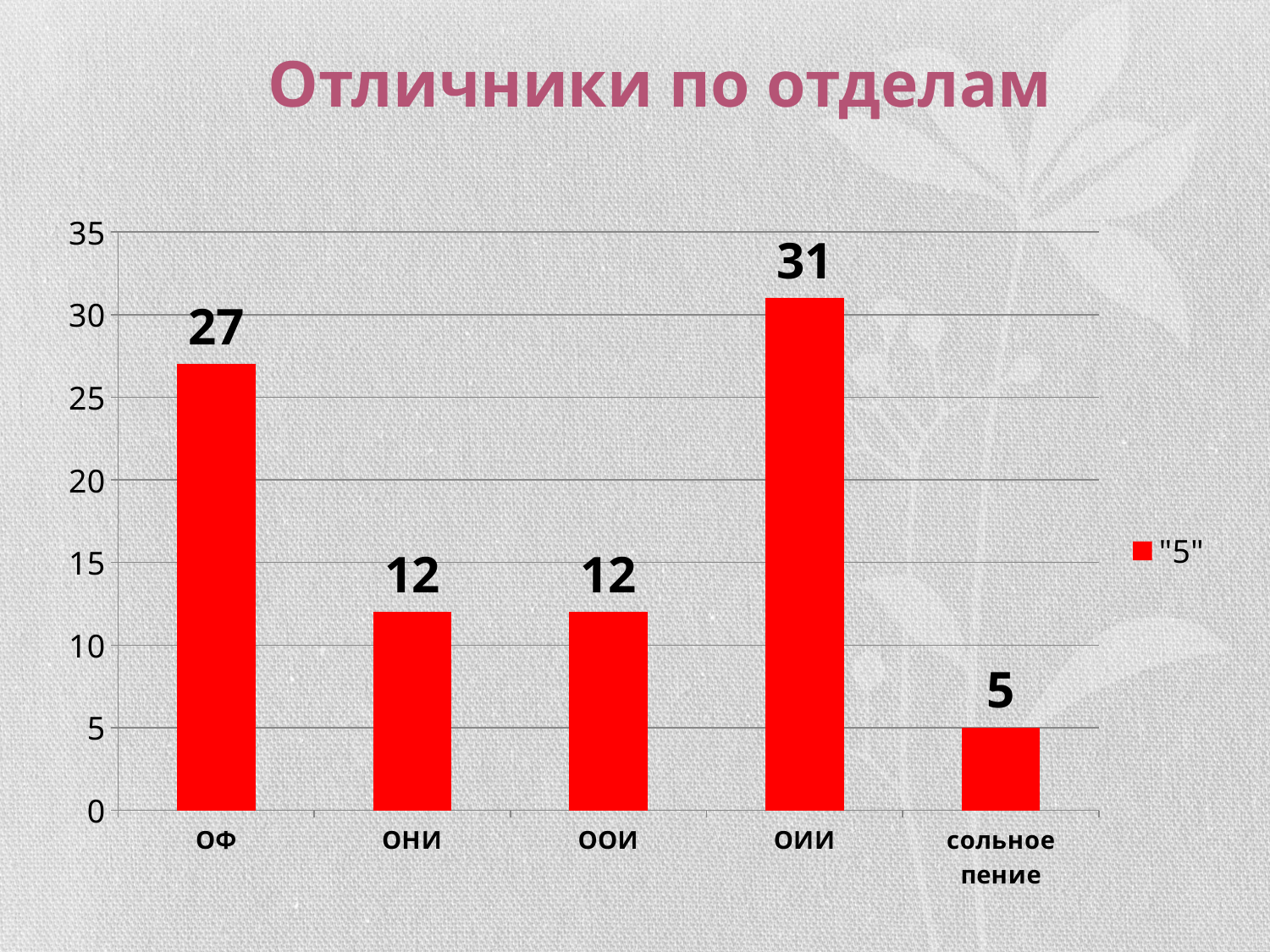
How many categories are shown on the x axis? 5 What is the value for ОФ? 27 How many series does the legend list? 1 Which is larger, the value for ОФ or the value for ООИ? ОФ Which category has the highest value? ОИИ What is the value for ОНИ? 12 What is the title of the chart? Отличники по отделам What kind of chart is shown on the slide? bar chart Which category has the lowest value? сольное пение What is the difference between the values for ОИИ and ОФ? 4 What is the value for ОИИ? 31 What is the value for сольное пение? 5